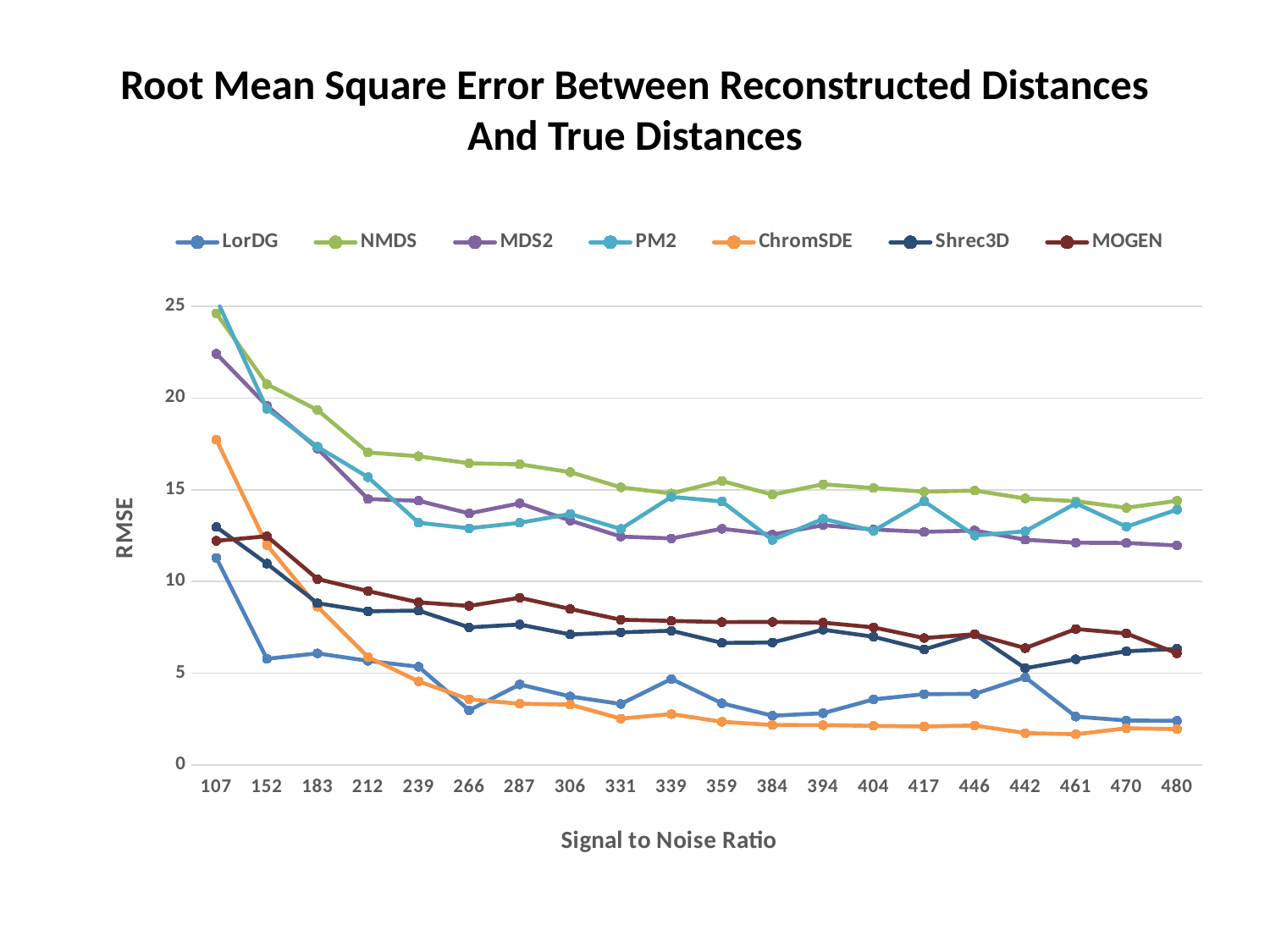
Which series has the highest RMSE at a signal to noise ratio of 212? NMDS How many signal-to-noise ratio values are plotted along the x axis? 20 Is the RMSE value for NMDS at a signal to noise ratio of 107 greater or less than 20? greater At a signal to noise ratio of 212, which series has the higher RMSE, MOGEN or Shrec3D? MOGEN Is the RMSE value for MOGEN at a signal to noise ratio of 107 greater or less than 15? less Does the RMSE for NMDS generally rise or fall as the signal to noise ratio increases? Fall How many series does the legend list? 7 Is the RMSE value for LorDG at a signal to noise ratio of 107 greater or less than 10? greater At a signal to noise ratio of 480, which series has the higher RMSE, NMDS or ChromSDE? NMDS What kind of chart is shown on the slide? Line chart What is the label of the y axis? RMSE